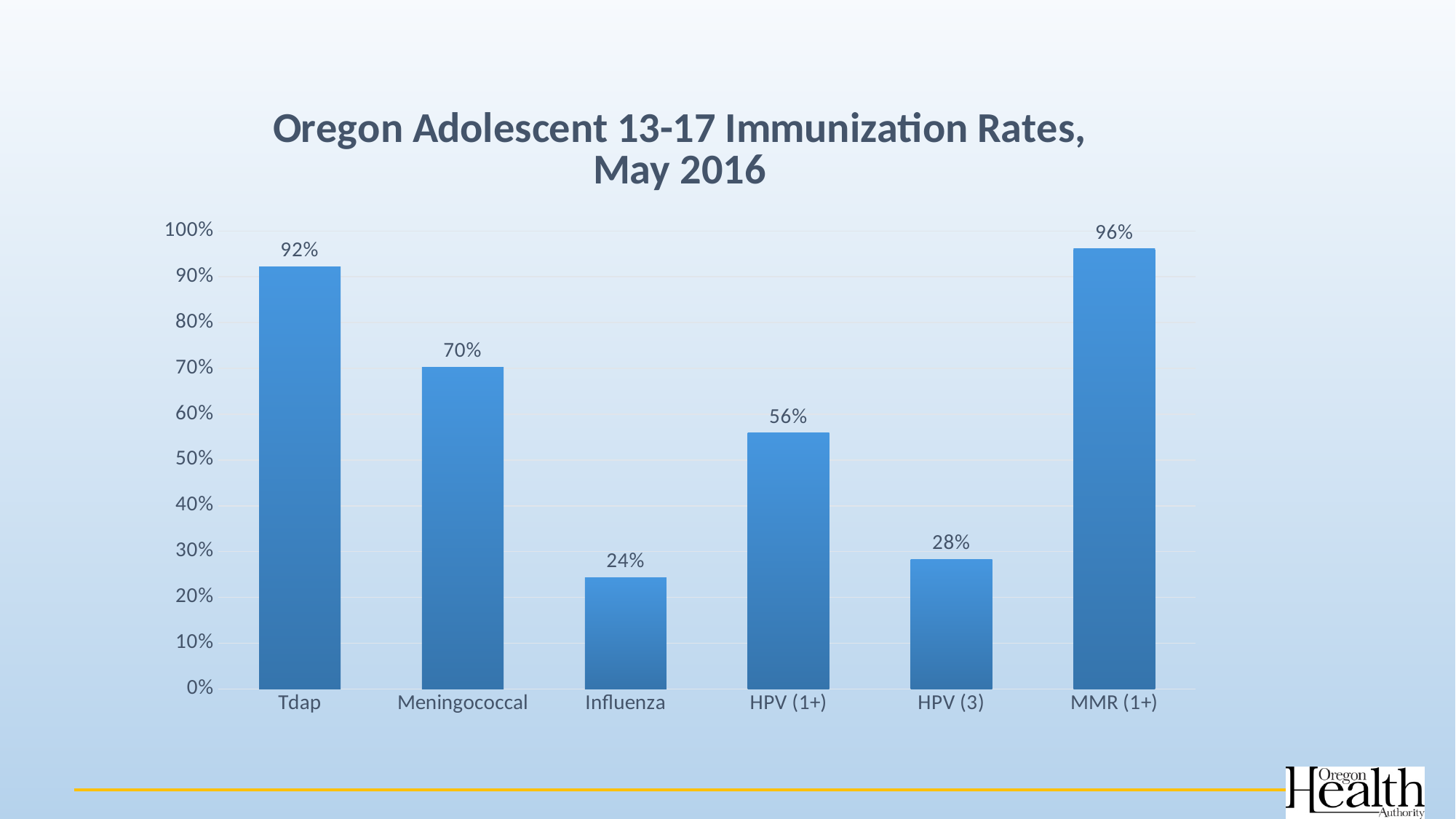
What is the immunization rate for Tdap? 92% What is the difference between the HPV (1+) rate and the HPV (3) rate? 28% What is the immunization rate for HPV (3)? 28% What is the difference between the MMR (1+) rate and the Tdap rate? 4% Is the value for Influenza greater or less than 30%? less Which vaccine has the highest immunization rate? MMR (1+) Which has a higher immunization rate, Meningococcal or HPV (1+)? Meningococcal Which vaccine has the lowest immunization rate? Influenza What is the title of the chart? Oregon Adolescent 13-17 Immunization Rates, May 2016 What kind of chart is shown on the slide? Bar chart What is the immunization rate for Meningococcal? 70% How many vaccine categories are shown in the chart? 6